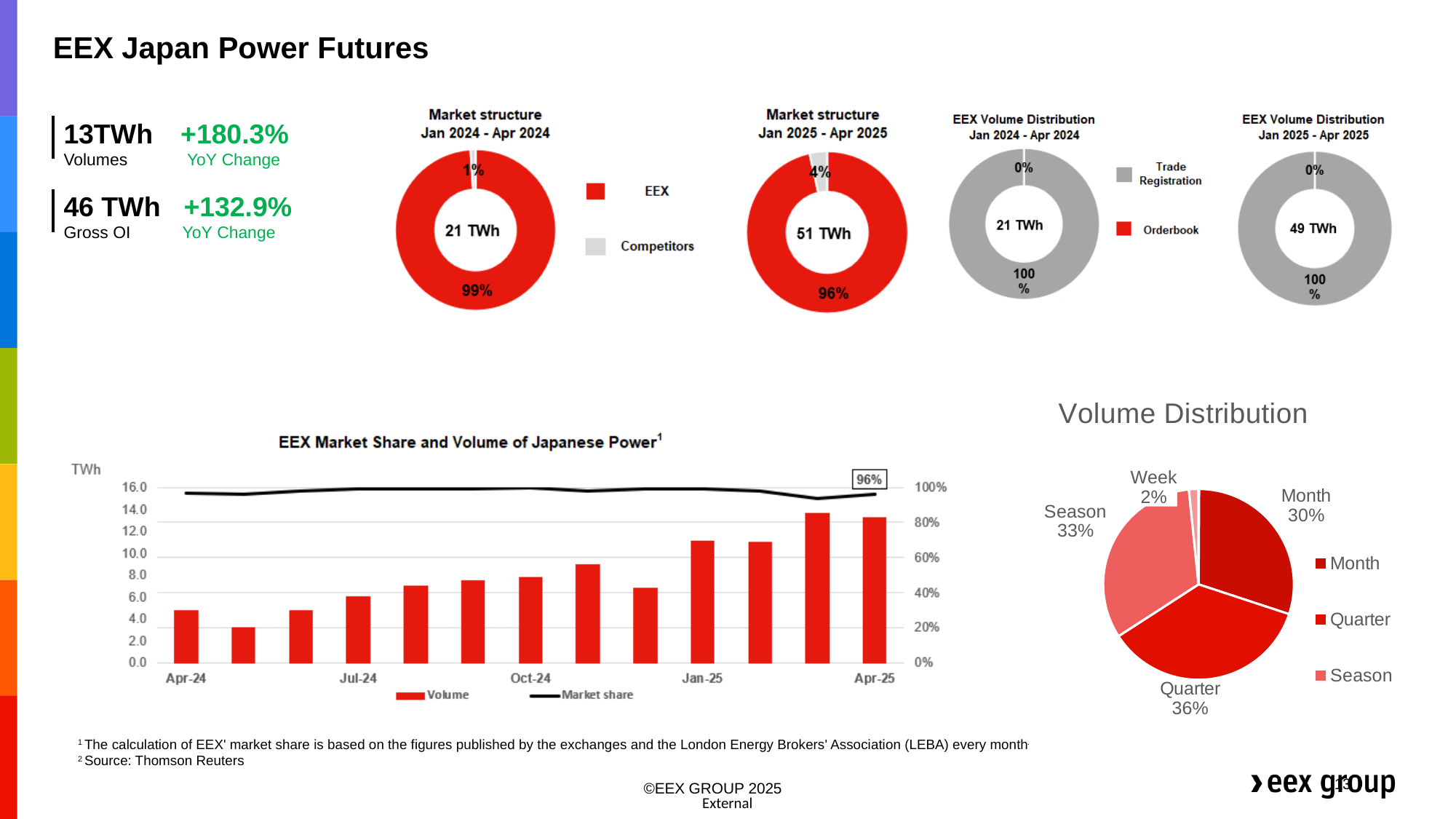
In the Market structure Jan 2025 - Apr 2025 donut chart, what share do Competitors hold? 4% In the EEX Market Share and Volume of Japanese Power chart, what market share value is labelled at Apr-25? 96% What total volume is shown in the centre of the Market structure Jan 2025 - Apr 2025 donut chart? 51 TWh In the EEX Market Share and Volume of Japanese Power chart, do the volume bars generally rise or fall from Apr-24 to Apr-25? rise In the Volume Distribution pie chart, which slice is the largest? Quarter How many bars are plotted in the EEX Market Share and Volume of Japanese Power chart? 13 In the Market structure Jan 2024 - Apr 2024 donut chart, what share does EEX hold? 99% In the Volume Distribution pie chart, what is the difference between the Quarter share and the Month share? 6% What total volume is shown in the centre of the EEX Volume Distribution Jan 2025 - Apr 2025 donut chart? 49 TWh In the EEX Volume Distribution Jan 2024 - Apr 2024 donut chart, what share is Orderbook? 0% In the EEX Market Share and Volume of Japanese Power chart, is the volume for Apr-24 greater or less than 6.0 TWh? less